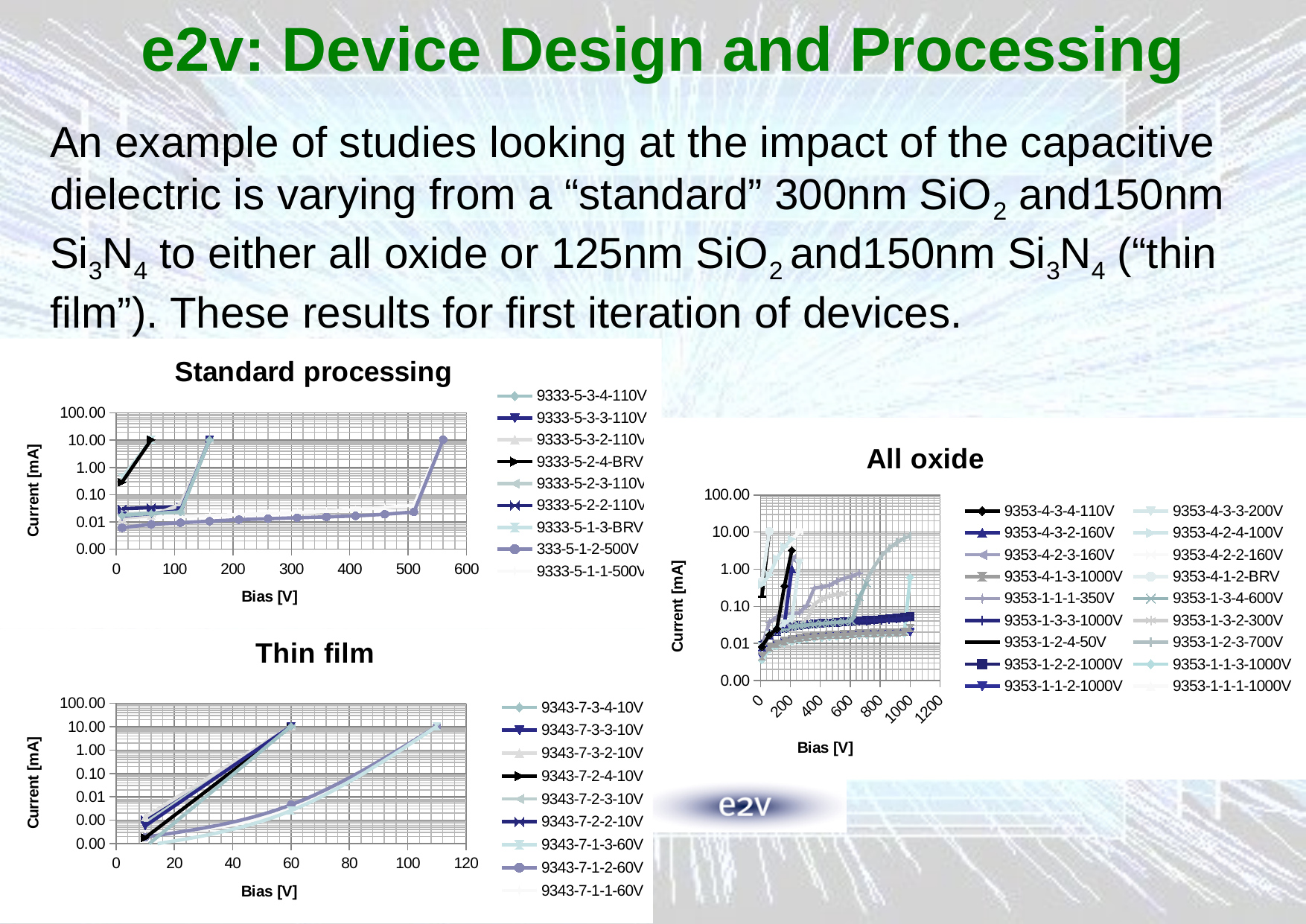
How many series does the legend of the "Standard processing" chart list? 9 How many series does the legend of the "Thin film" chart list? 9 In the "Thin film" chart, is the current for series 9343-7-1-2-60V at a bias of 60 V greater or less than 0.10 mA? less In the "Thin film" chart, is the current for series 9343-7-1-3-60V at a bias of 110 V greater or less than 1.00 mA? greater What kind of chart is the "Standard processing" chart? line chart In the "Thin film" chart, do the currents rise or fall as bias increases? rise What is the highest bias value shown on the x axis of the "All oxide" chart? 1200 What is the label of the y axis on the "Thin film" chart? Current [mA] How many charts are shown on the slide? 3 How many series does the legend of the "All oxide" chart list? 18 In the "Standard processing" chart, does the current for series 333-5-1-2-500V rise or fall as bias increases? rise